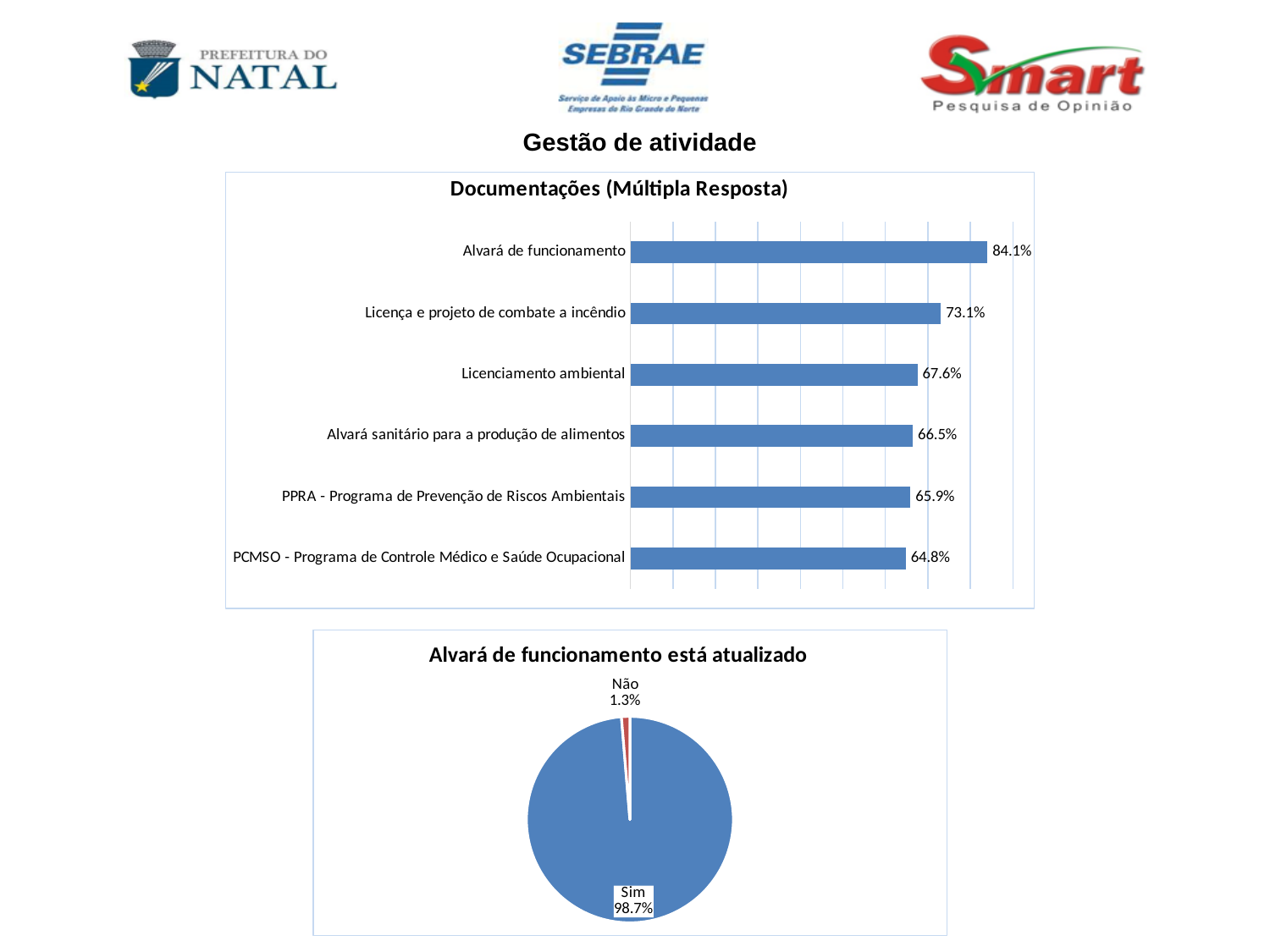
In the 'Documentações (Múltipla Resposta)' chart, what is the value for Licenciamento ambiental? 67.6% In the 'Alvará de funcionamento está atualizado' chart, what is the value for 'Não'? 1.3% In the 'Documentações (Múltipla Resposta)' chart, what is the value for Alvará de funcionamento? 84.1% What kind of chart is 'Documentações (Múltipla Resposta)'? Bar chart What kind of chart is 'Alvará de funcionamento está atualizado'? Pie chart In the 'Documentações (Múltipla Resposta)' chart, which category has the lowest value? PCMSO - Programa de Controle Médico e Saúde Ocupacional In the 'Documentações (Múltipla Resposta)' chart, which is larger: Alvará sanitário para a produção de alimentos or PPRA - Programa de Prevenção de Riscos Ambientais? Alvará sanitário para a produção de alimentos In the 'Documentações (Múltipla Resposta)' chart, what is the value for PCMSO - Programa de Controle Médico e Saúde Ocupacional? 64.8% In the 'Documentações (Múltipla Resposta)' chart, what is the difference between Alvará de funcionamento and Licença e projeto de combate a incêndio? 11.0% How many categories are shown in the 'Documentações (Múltipla Resposta)' chart? 6 In the 'Documentações (Múltipla Resposta)' chart, which category has the highest value? Alvará de funcionamento In the 'Alvará de funcionamento está atualizado' chart, what share of the pie is 'Sim'? 98.7%